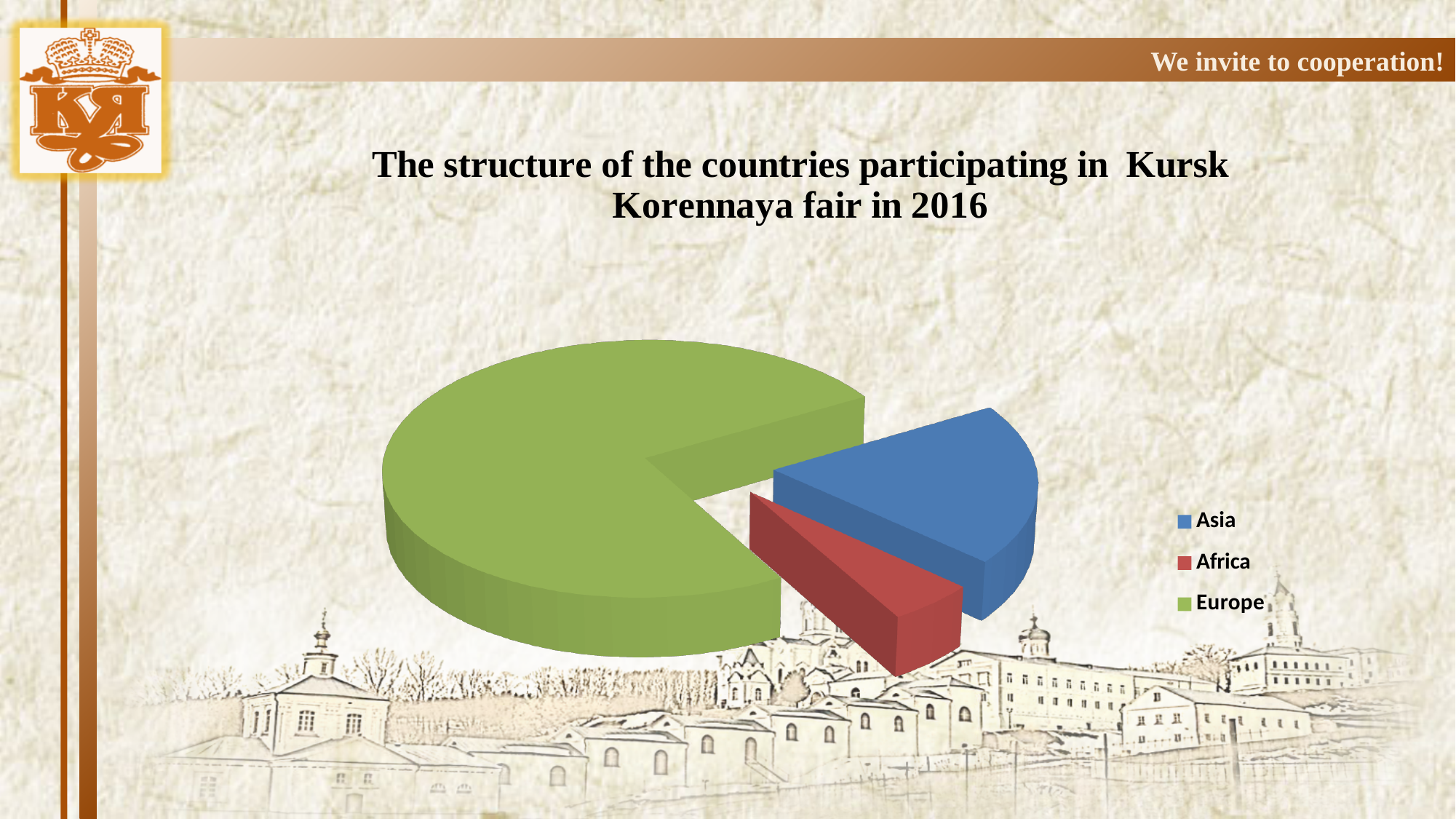
Which region has the largest slice in the pie chart? Europe What colour is the Europe slice in the pie chart? green Which slice is larger in the pie chart, Asia or Africa? Asia Which slice is larger in the pie chart, Europe or Asia? Europe How many slices does the pie chart have? 3 What kind of chart is shown on the slide? pie chart What is the title of the chart on the slide? The structure of the countries participating in Kursk Korennaya fair in 2016 Which slice is smaller in the pie chart, Africa or Europe? Africa Which region has the smallest slice in the pie chart? Africa How many entries does the legend of the pie chart list? 3